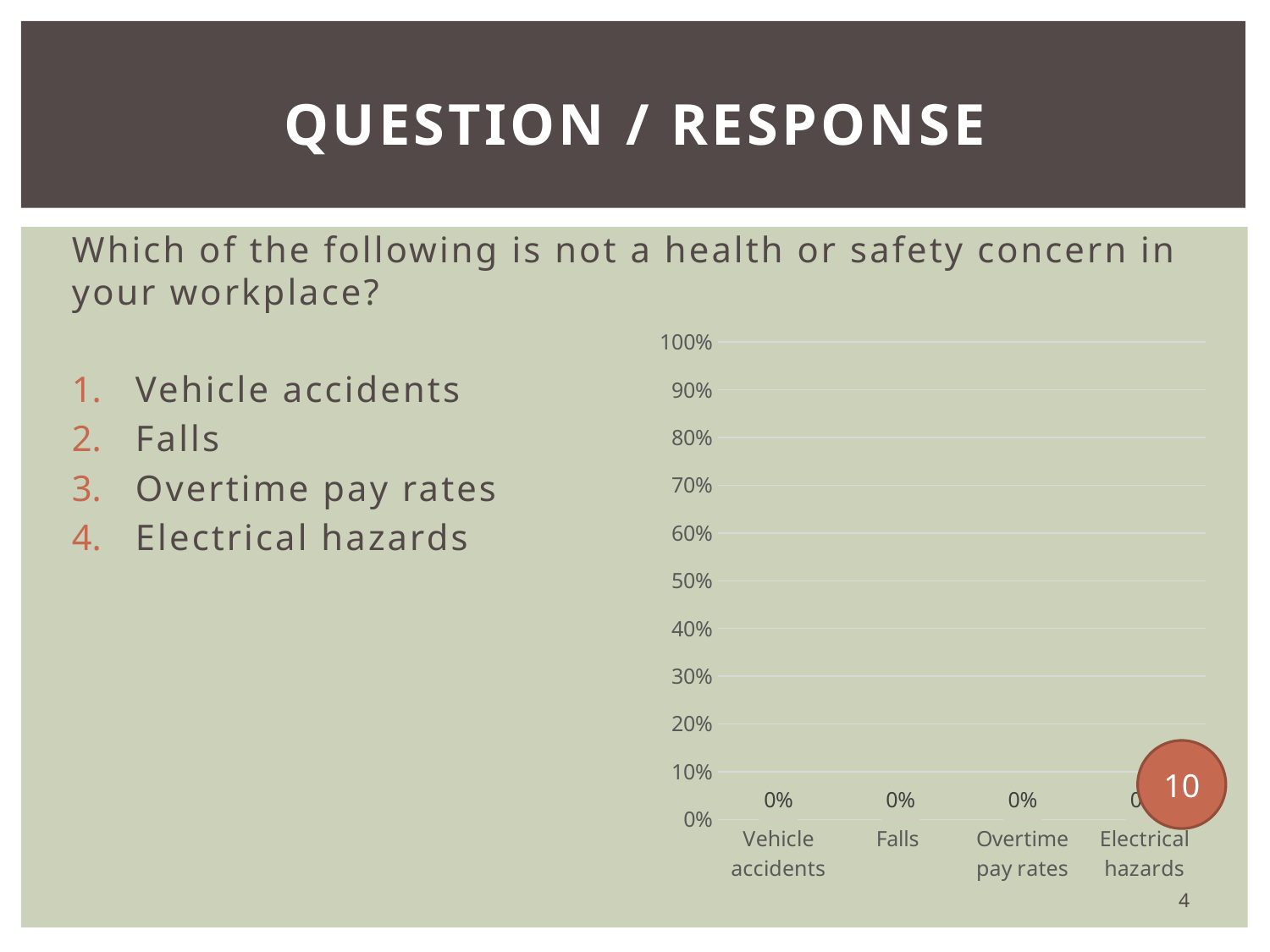
What is the difference between the values for Vehicle accidents and Falls? 0% What is the label of the first category on the x axis? Vehicle accidents How many categories are shown on the x axis of the chart? 4 Is the value for Overtime pay rates greater or less than 10%? less What is the value for Falls? 0% Is the value for Falls greater or less than 50%? less What is the value for Vehicle accidents? 0% What kind of chart is shown on the slide? bar chart What is the highest value shown on the y axis of the chart? 100% What is the value for Overtime pay rates? 0%